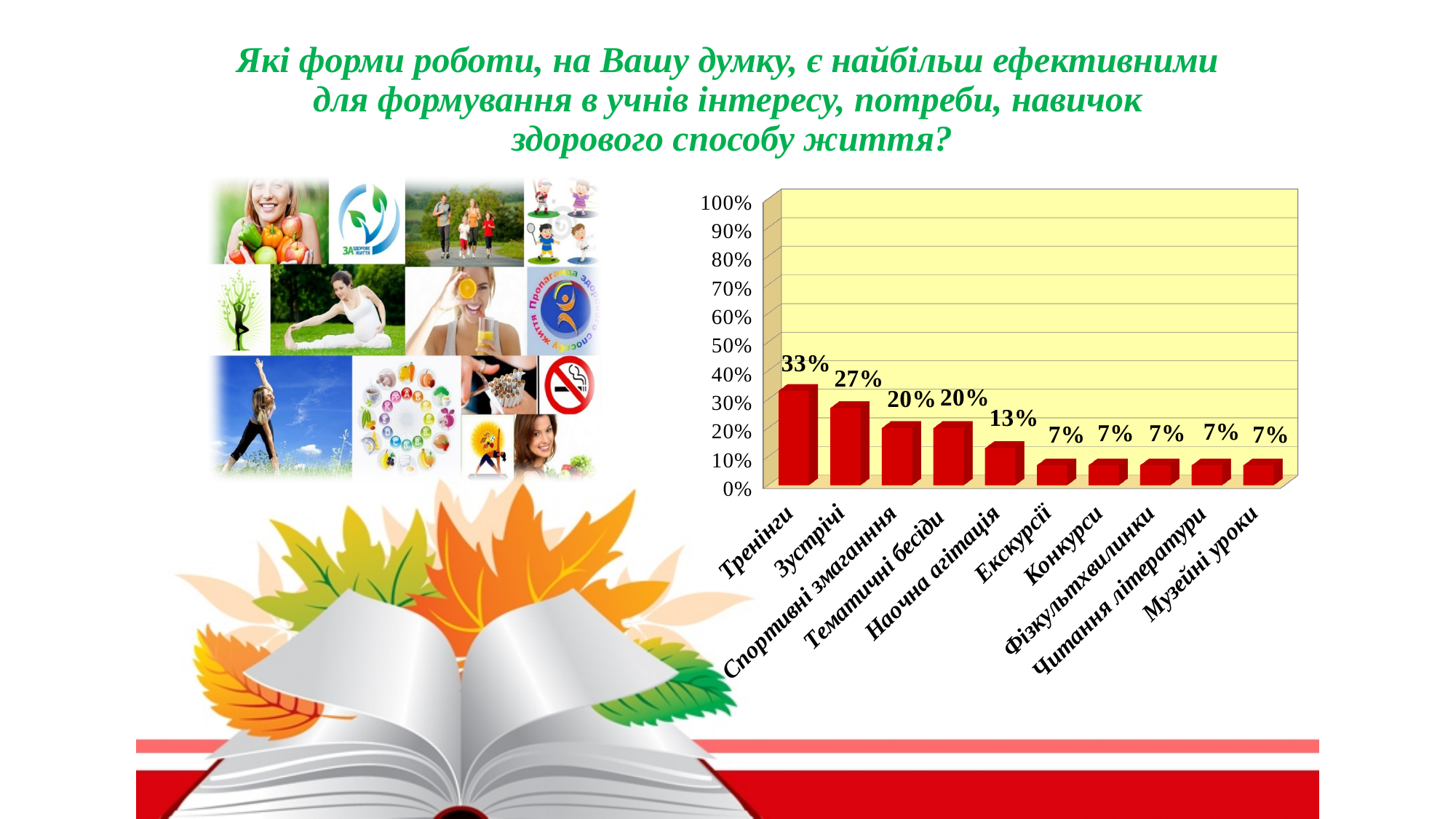
How many categories are shown on the x axis? 10 Is the value for Тренінги greater or less than 30%? greater Which category has the highest value? Тренінги What is the difference between the values for Спортивні змагання and Наочна агітація? 7% What is the value for Наочна агітація? 13% Do the values rise or fall from left to right along the x axis? fall What is the value for Тренінги? 33% What is the value for Екскурсії? 7% Which is larger, the value for Зустрічі or the value for Тематичні бесіди? Зустрічі What is the difference between the values for Тренінги and Зустрічі? 6% What is the value for Зустрічі? 27% What kind of chart is shown on the slide? bar chart